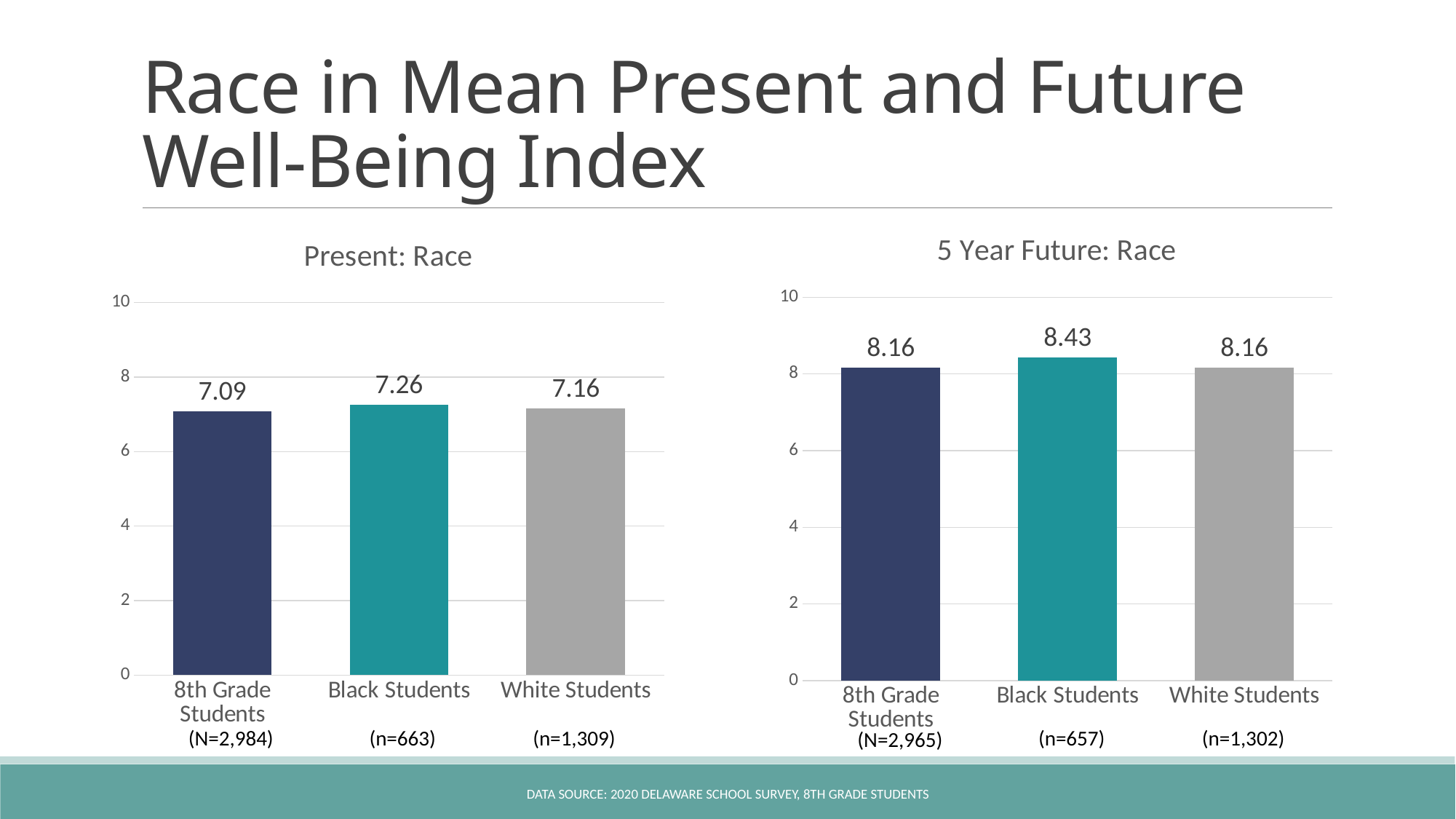
How many categories are shown in the '5 Year Future: Race' chart? 3 What kind of chart is the 'Present: Race' chart? Bar chart In the 'Present: Race' chart, what is the difference between the values for Black Students and 8th Grade Students? 0.17 In the 'Present: Race' chart, what is the value for 8th Grade Students? 7.09 In the 'Present: Race' chart, is the value for White Students greater or less than 8? less In the '5 Year Future: Race' chart, what is the value for White Students? 8.16 In the '5 Year Future: Race' chart, which category has the highest value? Black Students In the '5 Year Future: Race' chart, what is the value for Black Students? 8.43 In the 'Present: Race' chart, which category has the lowest value? 8th Grade Students In the 'Present: Race' chart, what is the value for Black Students? 7.26 In the '5 Year Future: Race' chart, what is the difference between the values for Black Students and White Students? 0.27 In the 'Present: Race' chart, which category has the highest value? Black Students